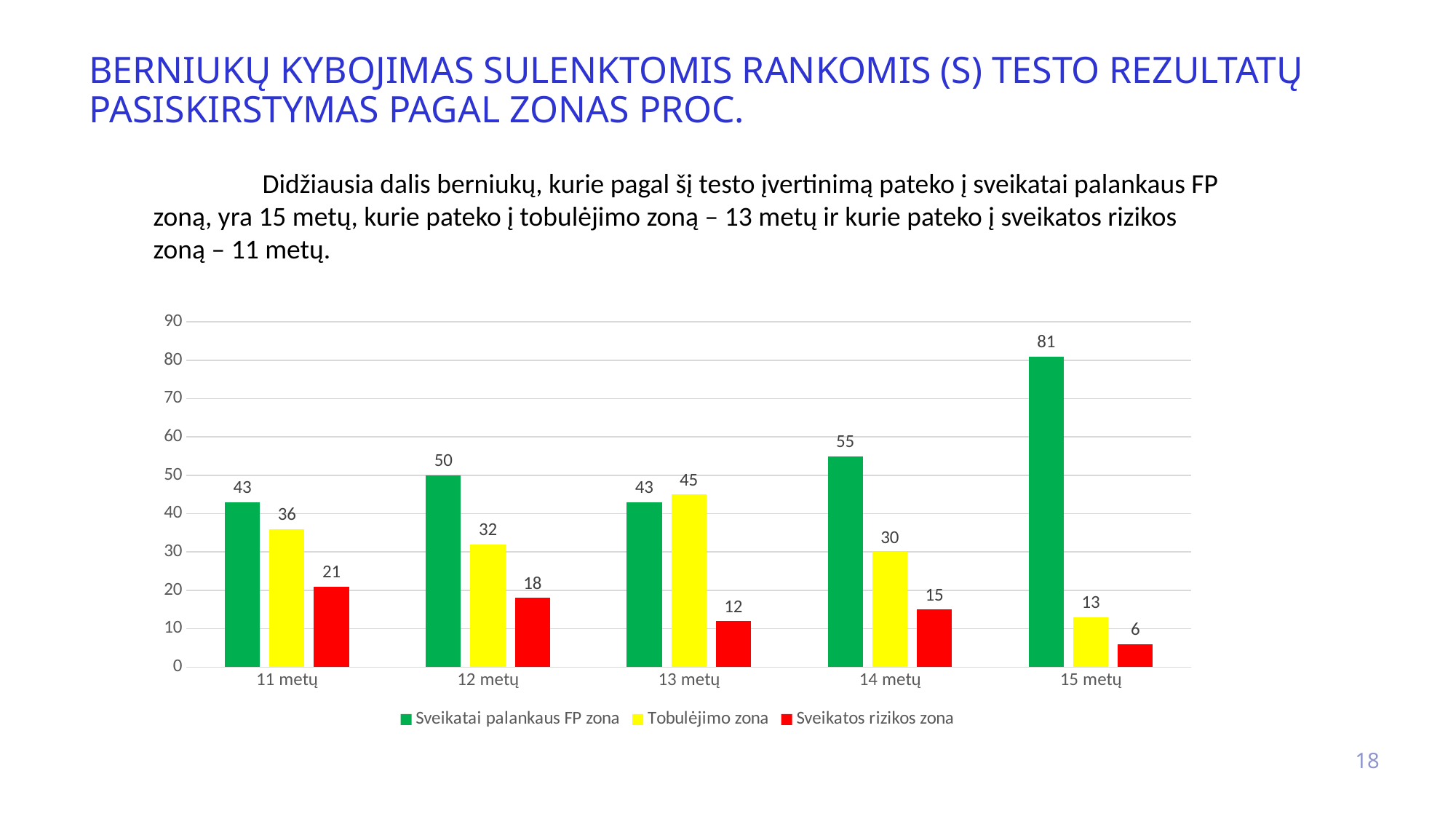
How many series does the legend list? 3 Which is larger at 13 metų: Sveikatai palankaus FP zona or Tobulėjimo zona? Tobulėjimo zona Which colour represents Tobulėjimo zona in the legend? Yellow How many age groups are shown on the x axis? 5 Which age group has the highest value for Sveikatai palankaus FP zona? 15 metų Which age group has the lowest value for Sveikatos rizikos zona? 15 metų What is the value for Sveikatos rizikos zona at 11 metų? 21 What is the value for Tobulėjimo zona at 13 metų? 45 Do the Sveikatos rizikos zona values rise or fall from 11 metų to 15 metų? Fall What is the value for Sveikatai palankaus FP zona at 15 metų? 81 What is the difference between the Sveikatai palankaus FP zona values for 15 metų and 14 metų? 26 What kind of chart is shown on the slide? Bar chart